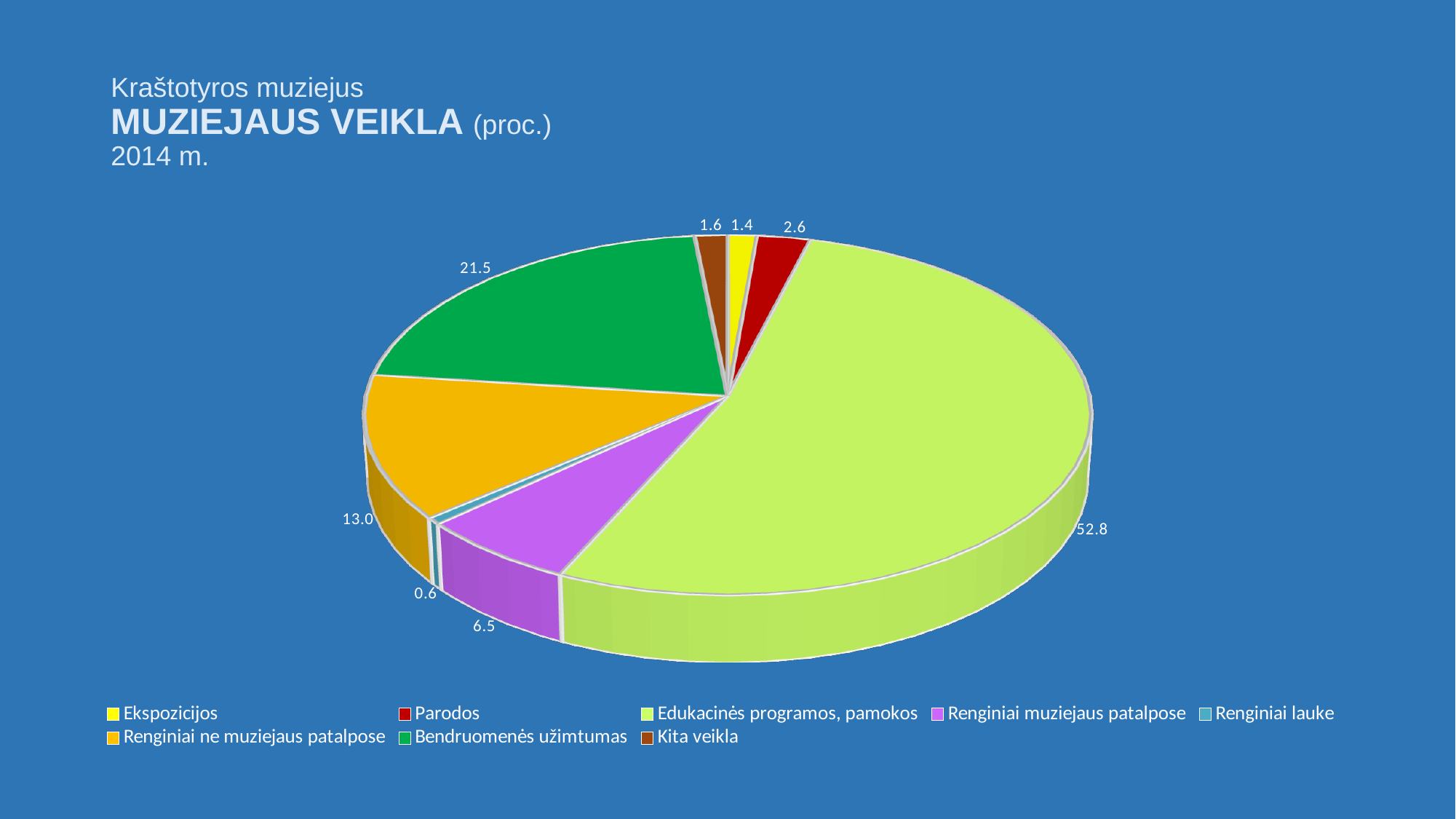
What is the difference between the values for Bendruomenės užimtumas and Renginiai ne muziejaus patalpose? 8.5 Which category has the largest slice? Edukacinės programos, pamokos What is the value for Parodos? 2.6 What is the value for Renginiai ne muziejaus patalpose? 13.0 What is the value for Edukacinės programos, pamokos? 52.8 Which is larger, Renginiai muziejaus patalpose or Parodos? Renginiai muziejaus patalpose What kind of chart is shown on the slide? Pie chart What year does the chart title refer to? 2014 m. What is the value for Bendruomenės užimtumas? 21.5 Which category has the smallest slice? Renginiai lauke How many categories does the pie chart show? 8 What is the value for Renginiai lauke? 0.6